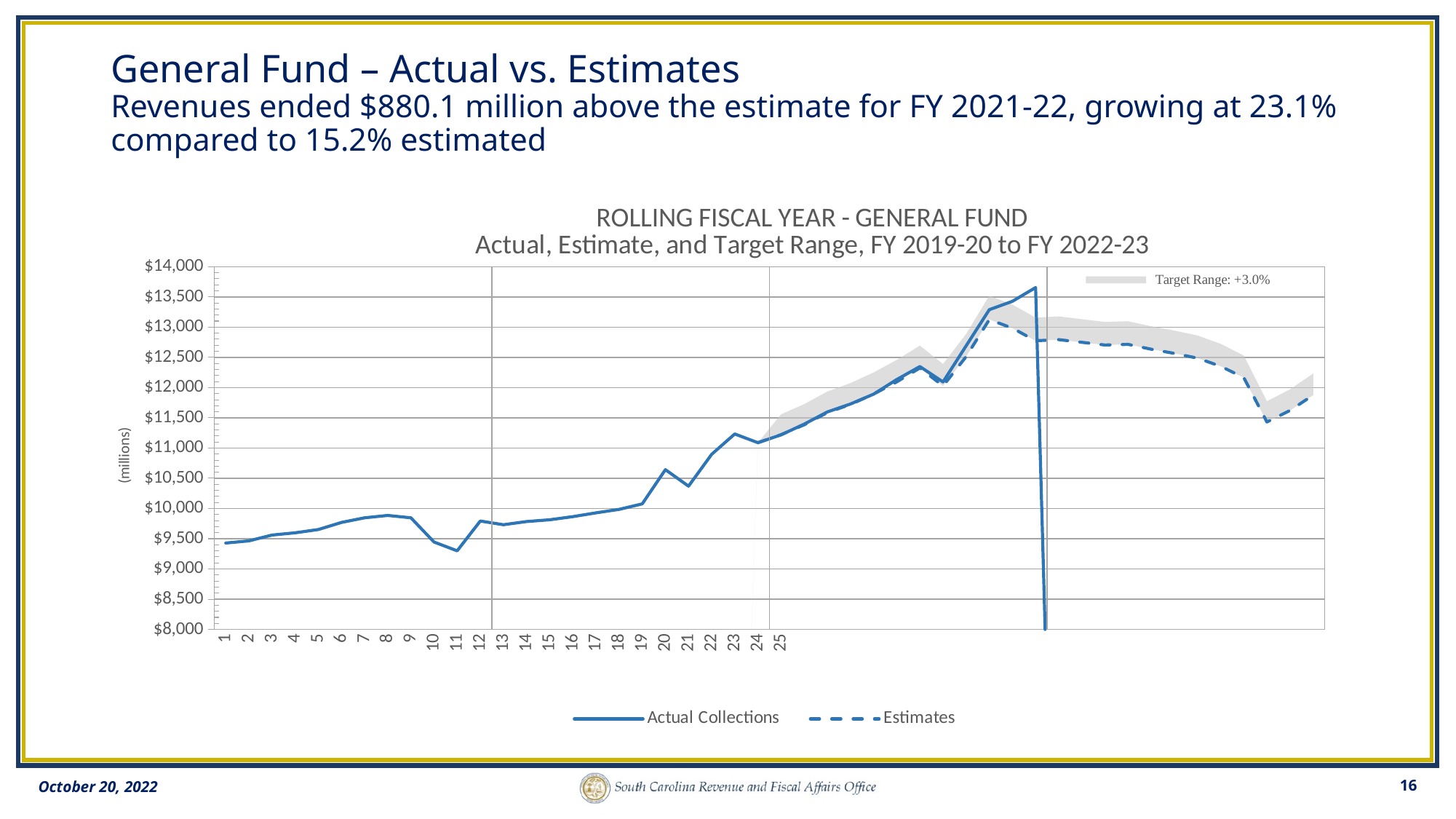
What are the two series named in the legend below the chart? Actual Collections and Estimates Do Actual Collections rise or fall from point 8 to point 11? fall How many numbered points are labeled on the x axis? 25 Is the Actual Collections value at point 11 greater or less than $9,500? less Is the Actual Collections value at point 8 greater or less than $10,000? less Is the Actual Collections value at point 23 greater or less than $11,000? greater How many series does the legend below the chart list? 2 Do Actual Collections rise or fall from point 1 to point 8? rise What is the unit shown on the y-axis label of the chart? (millions) What kind of chart is shown on the slide? line chart